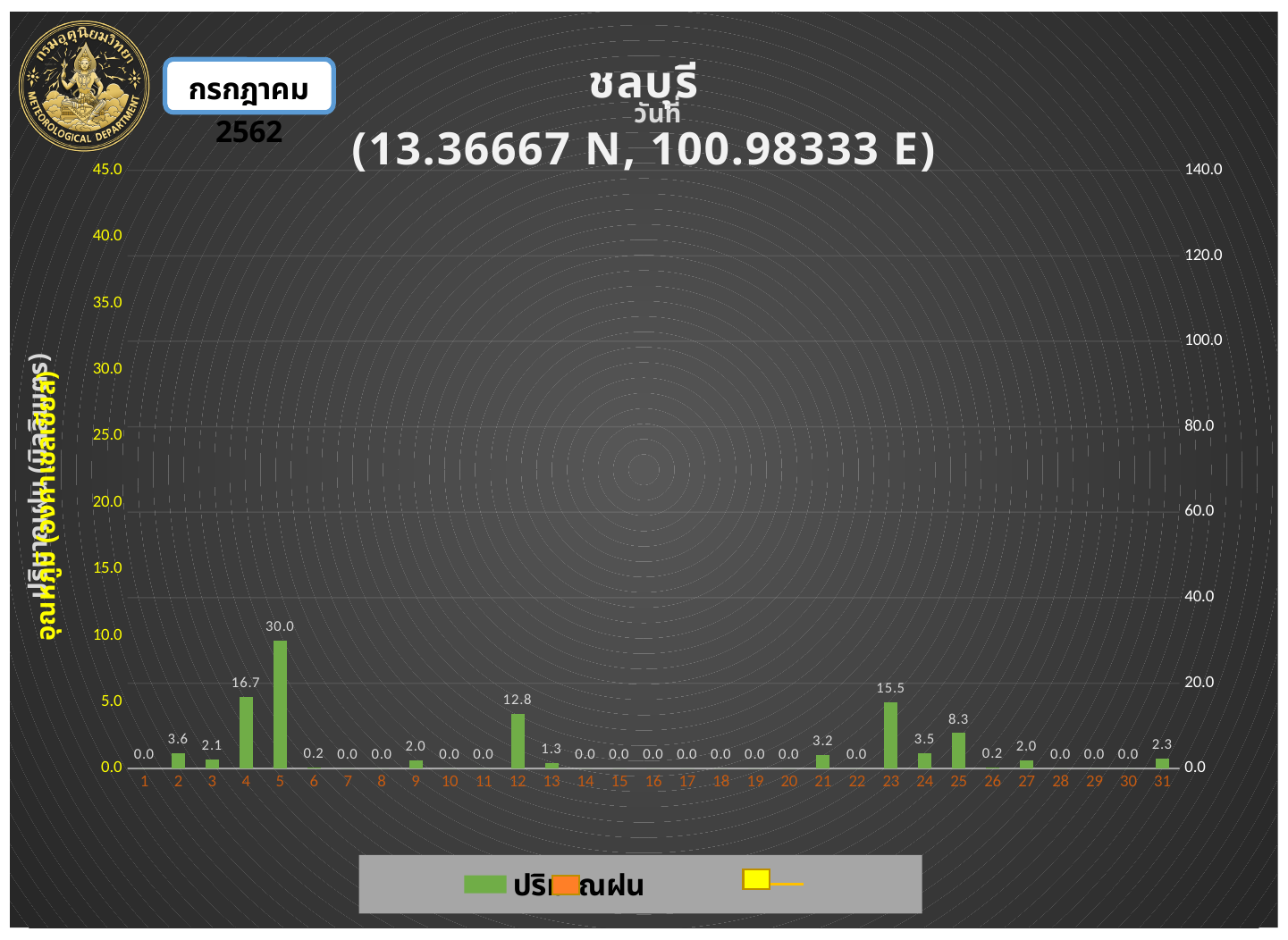
What coordinates are given in the chart title? 13.36667 N, 100.98333 E What is the rainfall value shown for day 23? 15.5 What kind of chart is shown on the slide? bar chart What is the rainfall value shown for day 12? 12.8 Which is larger, the rainfall value for day 4 or for day 25? day 4 What is the rainfall value shown for day 5? 30.0 Which is larger, the rainfall value for day 2 or for day 24? day 2 Which day has the highest rainfall value? 5 What is the difference between the rainfall values for day 5 and day 4? 13.3 What is the difference between the rainfall values for day 23 and day 12? 2.7 What is the rainfall value shown for day 25? 8.3 How many days are shown on the x axis? 31